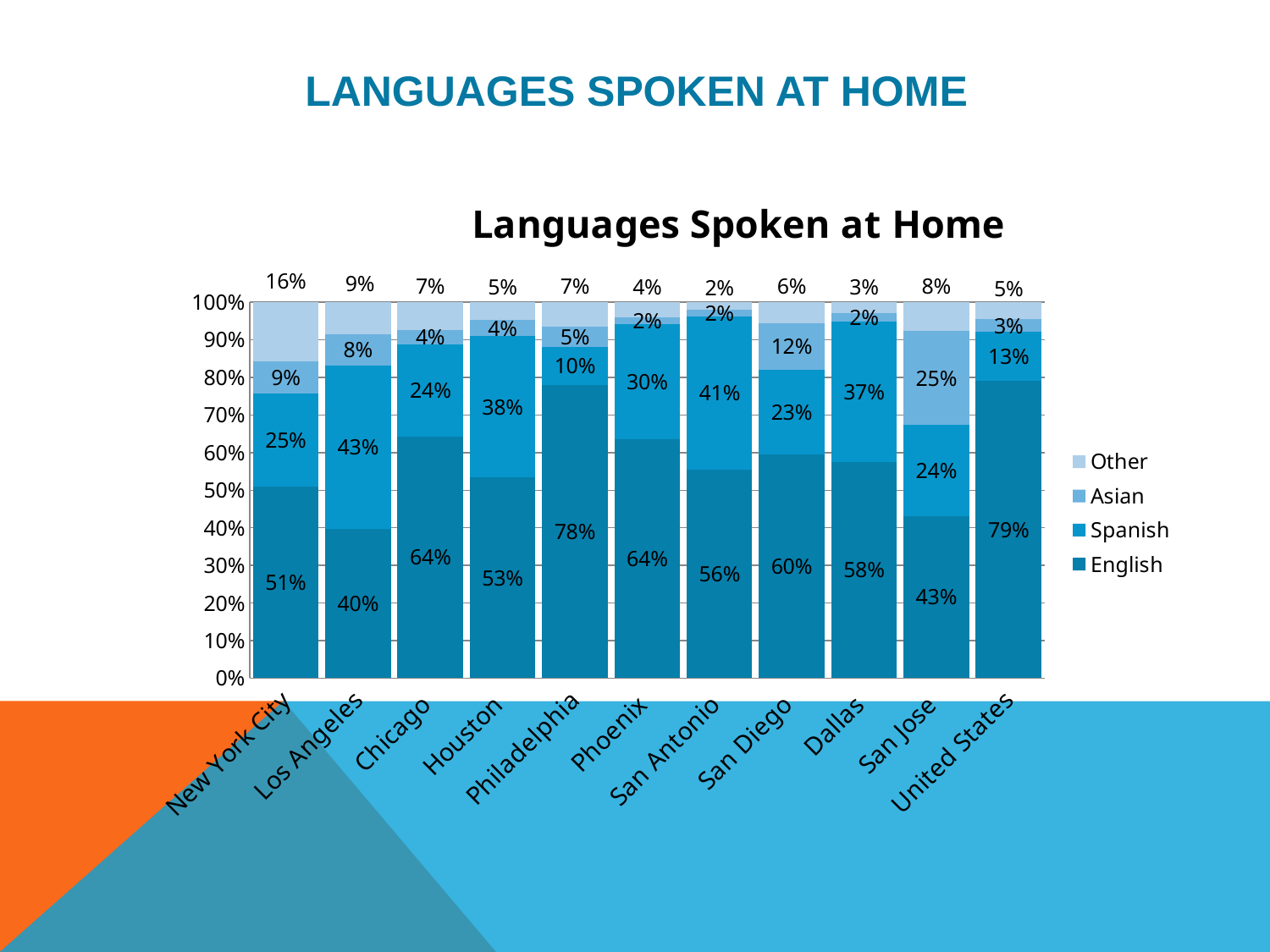
Which category has the highest English share? United States Which category has the lowest English share? Los Angeles Which is larger, the English share for Philadelphia or the English share for Phoenix? Philadelphia Which series is listed first in the legend? Other How many cities or regions are shown along the x axis? 11 What is the English share for Los Angeles? 40% How many series does the legend list? 4 Which category has the highest Other share? New York City What is the Asian share for San Jose? 25% What is the Spanish share for Houston? 38% What is the difference between the Spanish share for Los Angeles and the Spanish share for Chicago? 19% What kind of chart is shown on the slide? Stacked bar chart